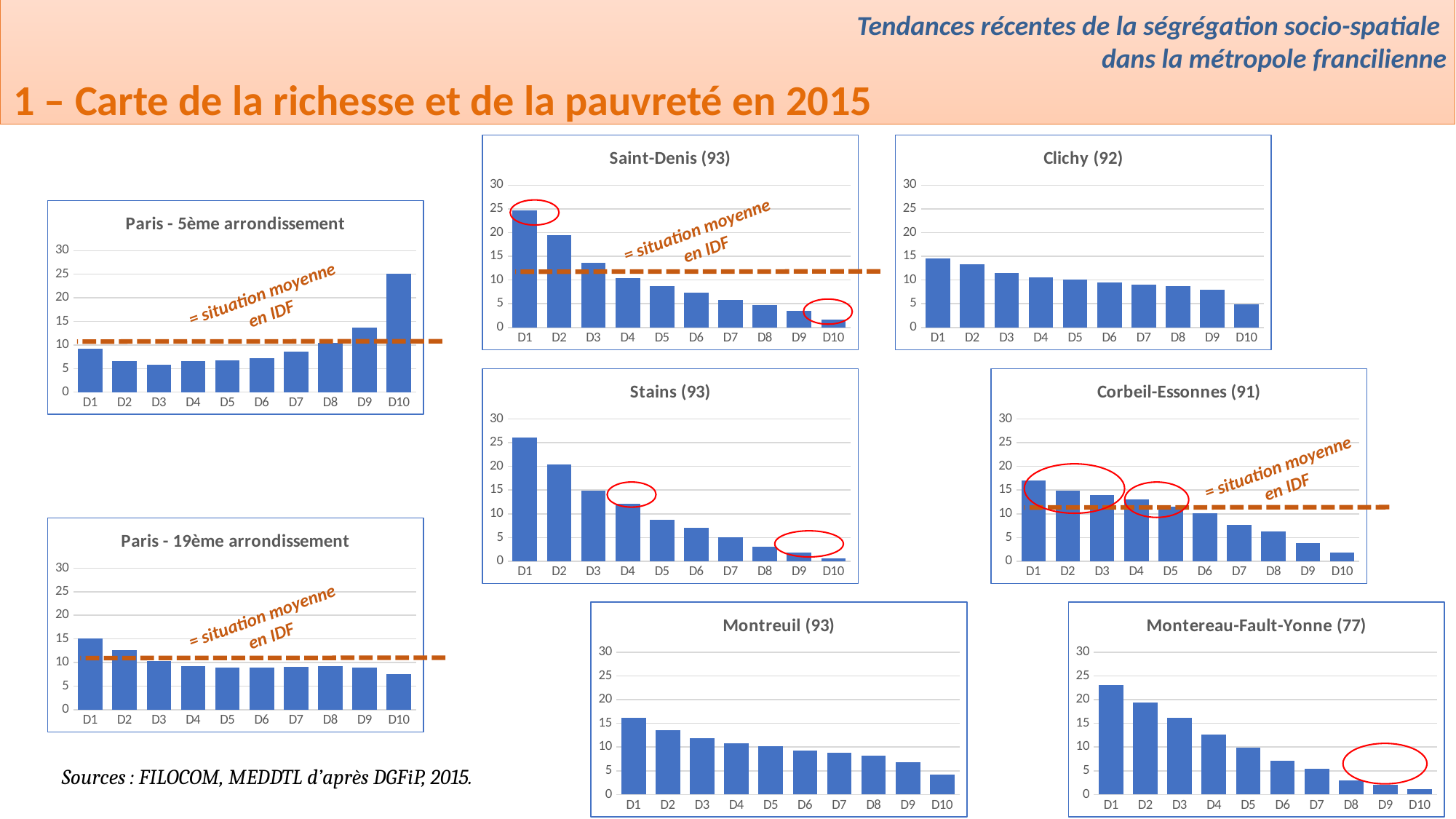
In the Montreuil (93) chart, is the value for D10 greater or less than 5? less In the Saint-Denis (93) chart, which decile has the lowest value? D10 In the Clichy (92) chart, which decile has the highest value? D1 In the Paris - 5ème arrondissement chart, is the value for D10 greater or less than 20? greater In the Paris - 5ème arrondissement chart, which decile has the highest value? D10 In the Stains (93) chart, do the values rise or fall from D1 to D10? fall How many deciles are shown on the x axis of the Paris - 19ème arrondissement chart? 10 In the Corbeil-Essonnes (91) chart, which is larger, the value for D1 or the value for D10? D1 In the Stains (93) chart, is the value for D1 greater or less than 20? greater What kind of chart is the Montreuil (93) chart? bar chart